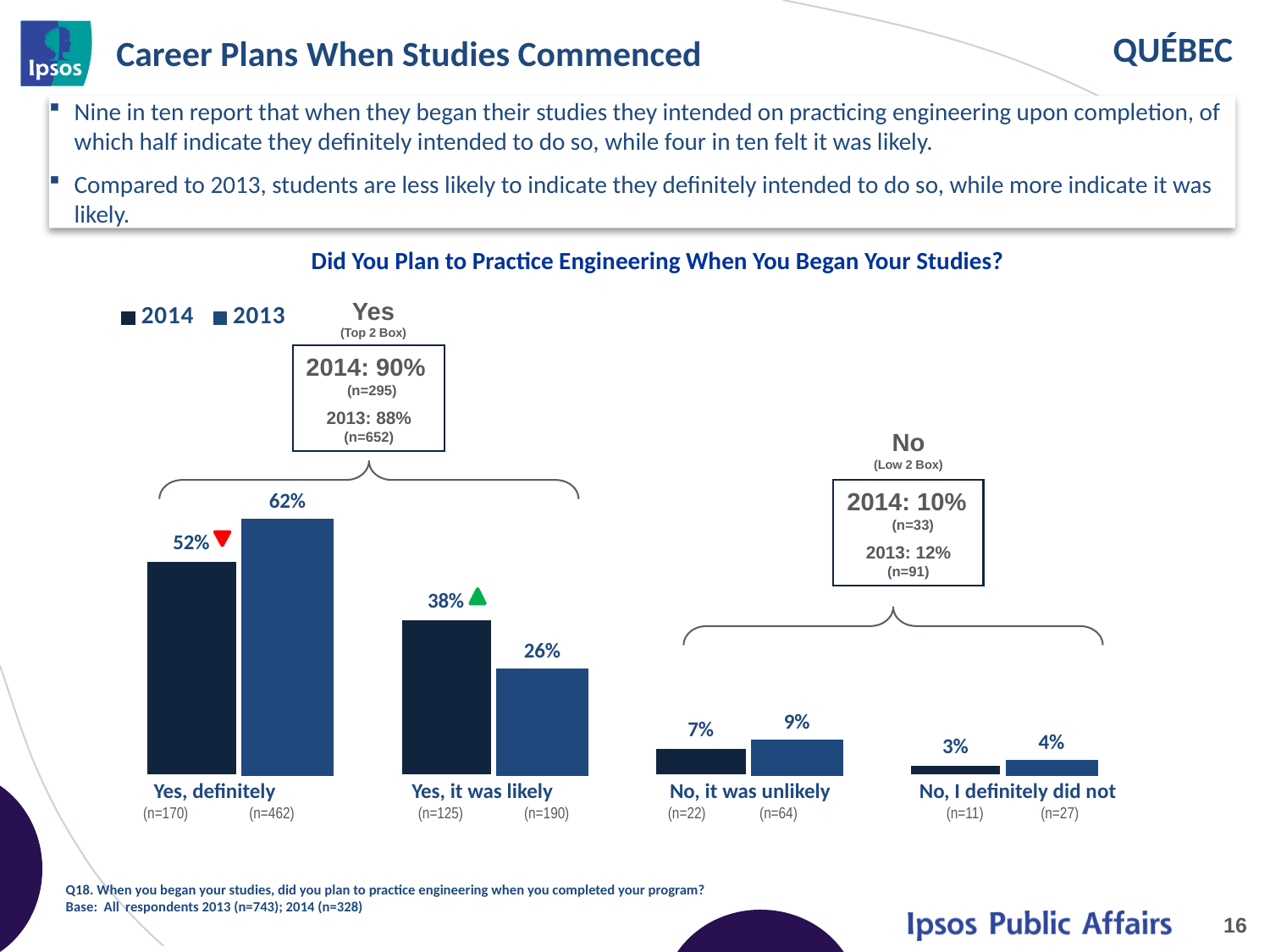
What is the 2013 value for "No, it was unlikely"? 9% How many series does the legend list? 2 Which category has the highest 2013 value? Yes, definitely What is the difference between the 2014 and 2013 values for "Yes, it was likely"? 12% What is the 2014 value for "Yes, definitely"? 52% What is the 2013 value for "Yes, it was likely"? 26% Which category has the lowest 2014 value? No, I definitely did not Which is larger for "Yes, it was likely": the 2014 value or the 2013 value? 2014 What kind of chart is shown on the slide? Bar chart What is the 2014 value for "No, I definitely did not"? 3% How many categories are shown on the x axis? 4 What is the difference between the 2013 and 2014 values for "Yes, definitely"? 10%